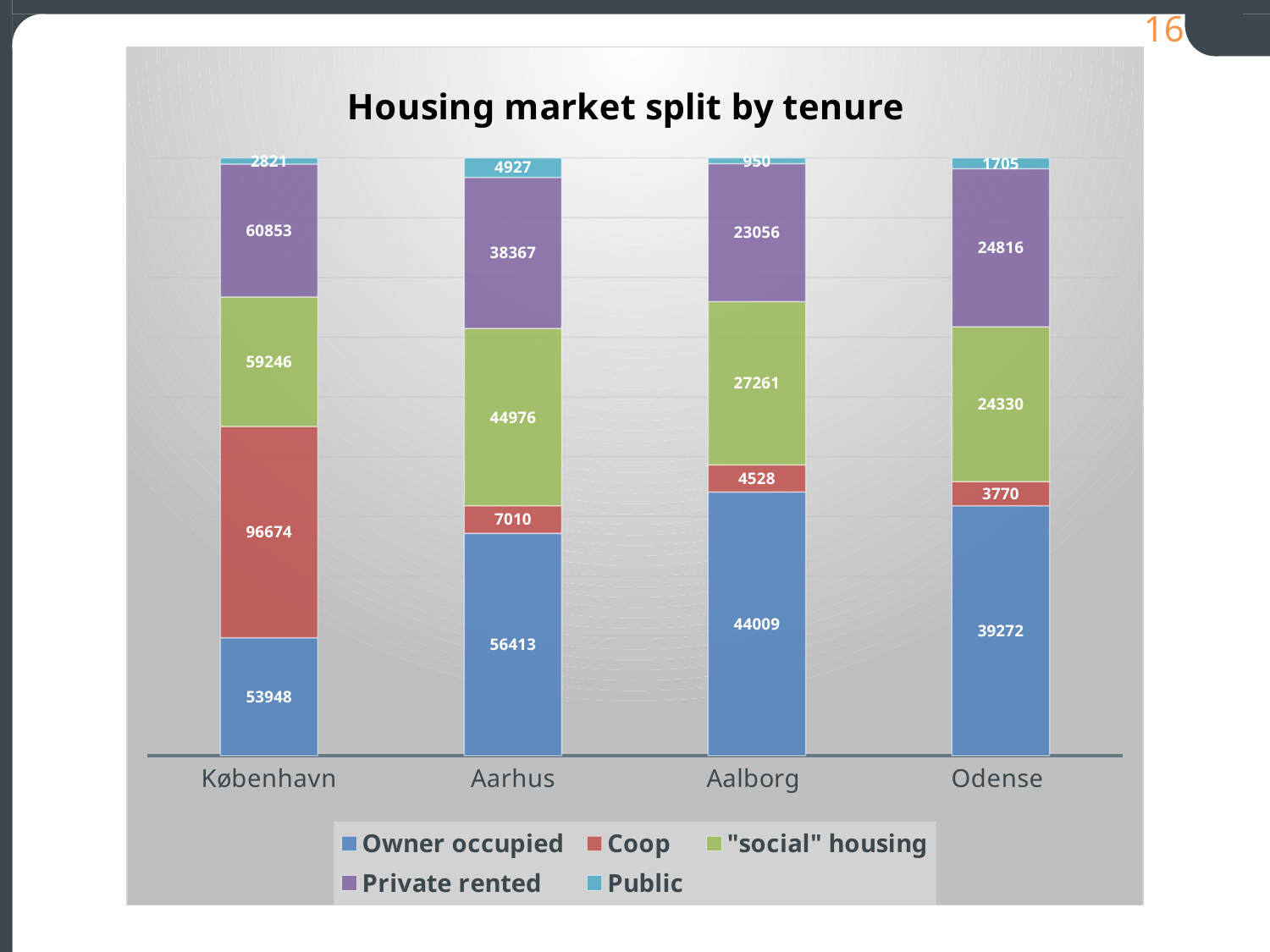
What is the Public value for Odense? 1705 What is the difference between the Coop values for Aarhus and Odense? 3240 Which is larger, the Owner occupied value for Aalborg or for Odense? Aalborg Which city has the lowest Public value? Aalborg Which city has the highest Private rented value? København What is the Owner occupied value for Aarhus? 56413 What is the total of all tenure values for Aalborg? 99804 What is the Coop value for København? 96674 How many series does the legend list? 5 How many cities are shown on the x axis? 4 What kind of chart is shown? Stacked bar chart What is the "social" housing value for Aalborg? 27261